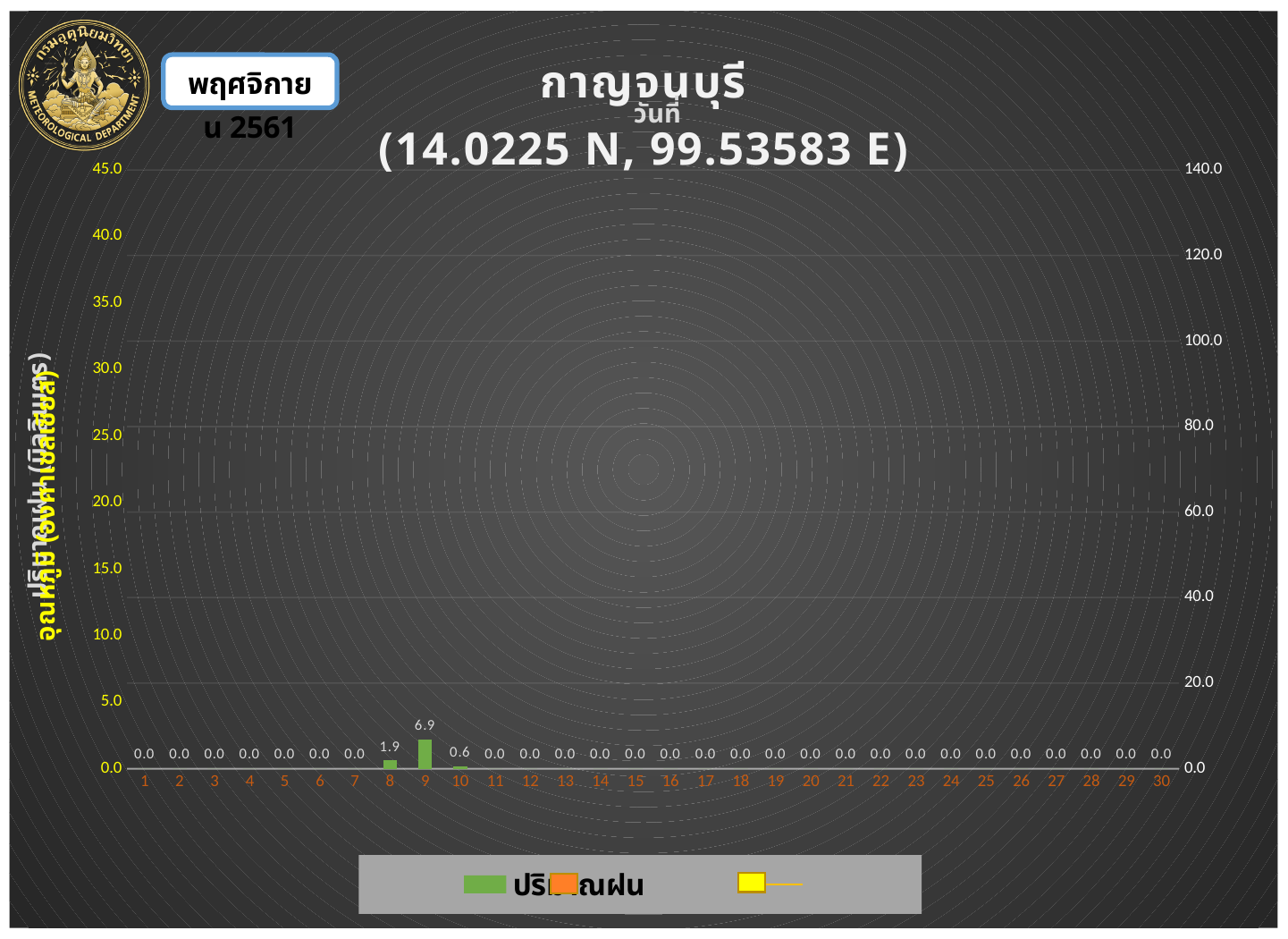
What is the difference between the rainfall values for day 8 and day 10? 1.3 How many days are shown on the x axis? 30 Is the rainfall value for day 9 greater or less than 10.0 on the left axis? less Which day has the highest rainfall value? 9 What is the rainfall value shown for day 15? 0.0 What is the difference between the rainfall values for day 9 and day 8? 5.0 What kind of chart is used to show the rainfall values? bar chart What is the rainfall value shown for day 9? 6.9 What is the rainfall value shown for day 8? 1.9 Which is larger, the rainfall value for day 8 or for day 10? day 8 What is the rainfall value shown for day 10? 0.6 What is the highest value labelled on the right-hand vertical axis? 140.0